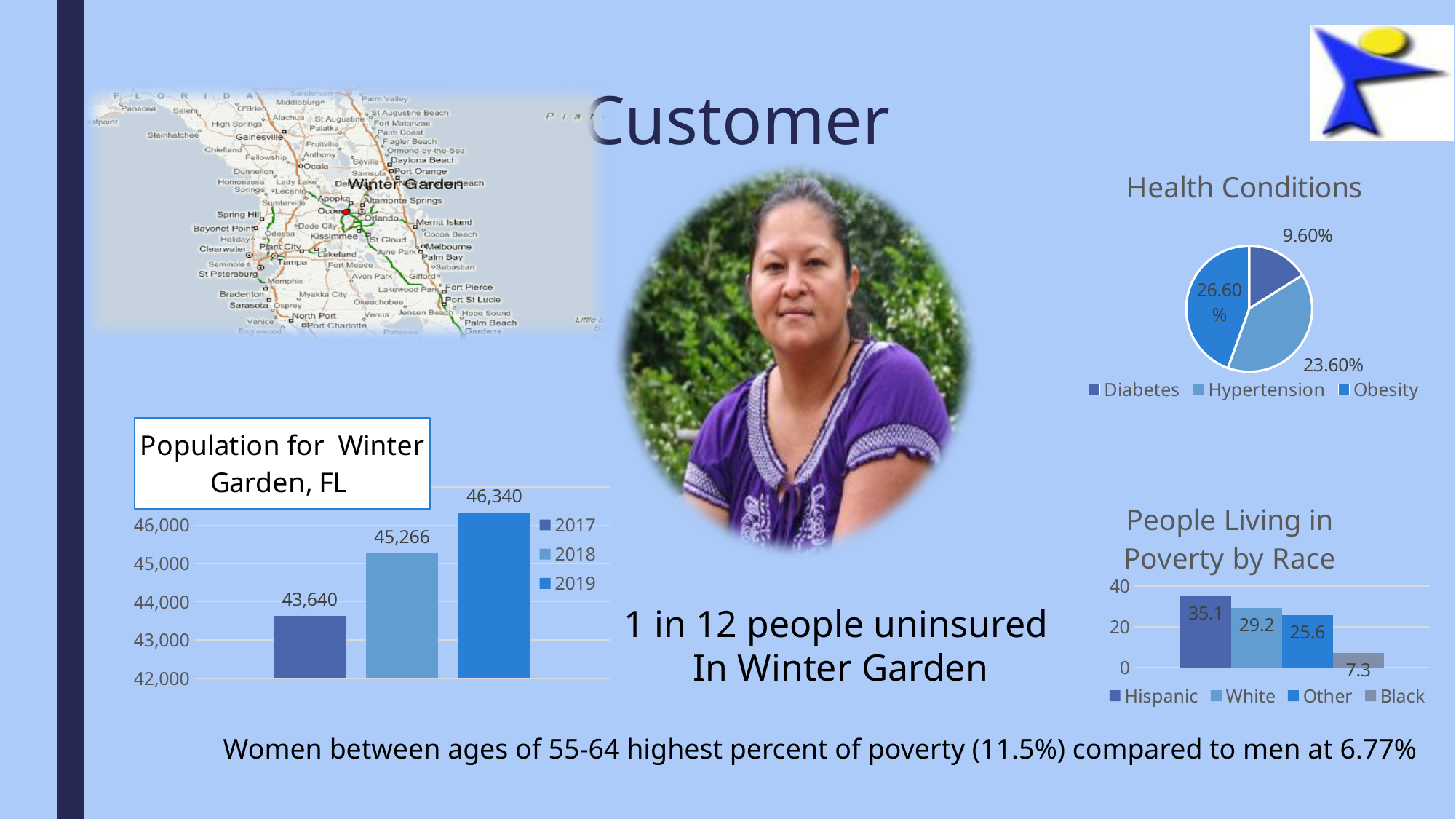
In the 'Population for Winter Garden, FL' chart, do the values rise or fall from 2017 to 2019? rise How many entries does the legend of the 'Health Conditions' chart list? 3 In the 'Population for Winter Garden, FL' chart, what is the population for 2019? 46,340 In the 'Health Conditions' chart, what percentage is shown for Obesity? 26.60% In the 'Health Conditions' chart, what percentage is shown for Diabetes? 9.60% In the 'People Living in Poverty by Race' chart, what is the difference between the Hispanic and Black values? 27.8 In the 'Health Conditions' chart, which condition has the smallest slice? Diabetes In the 'People Living in Poverty by Race' chart, which race has the highest value? Hispanic In the 'Population for Winter Garden, FL' chart, what is the difference between the 2019 and 2017 values? 2,700 In the 'Population for Winter Garden, FL' chart, what is the population for 2017? 43,640 In the 'People Living in Poverty by Race' chart, what is the value for White? 29.2 What kind of chart is the 'Population for Winter Garden, FL' chart? bar chart